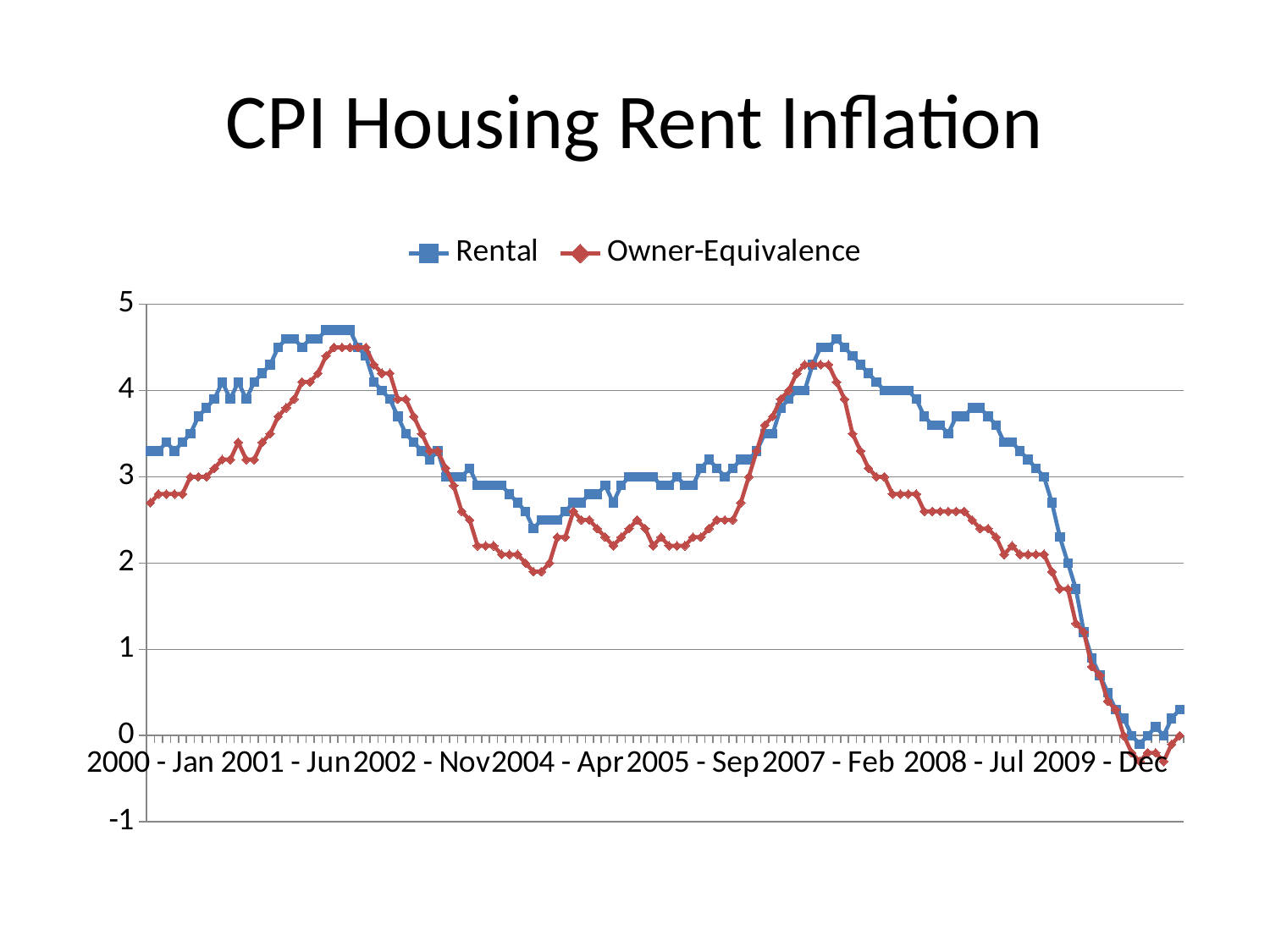
Do the Rental values rise or fall between 2008 - Jul and 2009 - Dec? fall Which series is drawn with red diamond markers? Owner-Equivalence Is the Owner-Equivalence value at 2008 - Jul greater or less than 3? less Is the Owner-Equivalence value at 2000 - Jan greater or less than 3? less How many series does the legend list? 2 Is the Rental value at 2007 - Feb greater or less than 4? greater Which series reaches the higher peak around 2001 - Jun, Rental or Owner-Equivalence? Rental What kind of chart is shown on the slide? line chart At 2008 - Jul, which series has the higher value, Rental or Owner-Equivalence? Rental What is the title of the chart? CPI Housing Rent Inflation